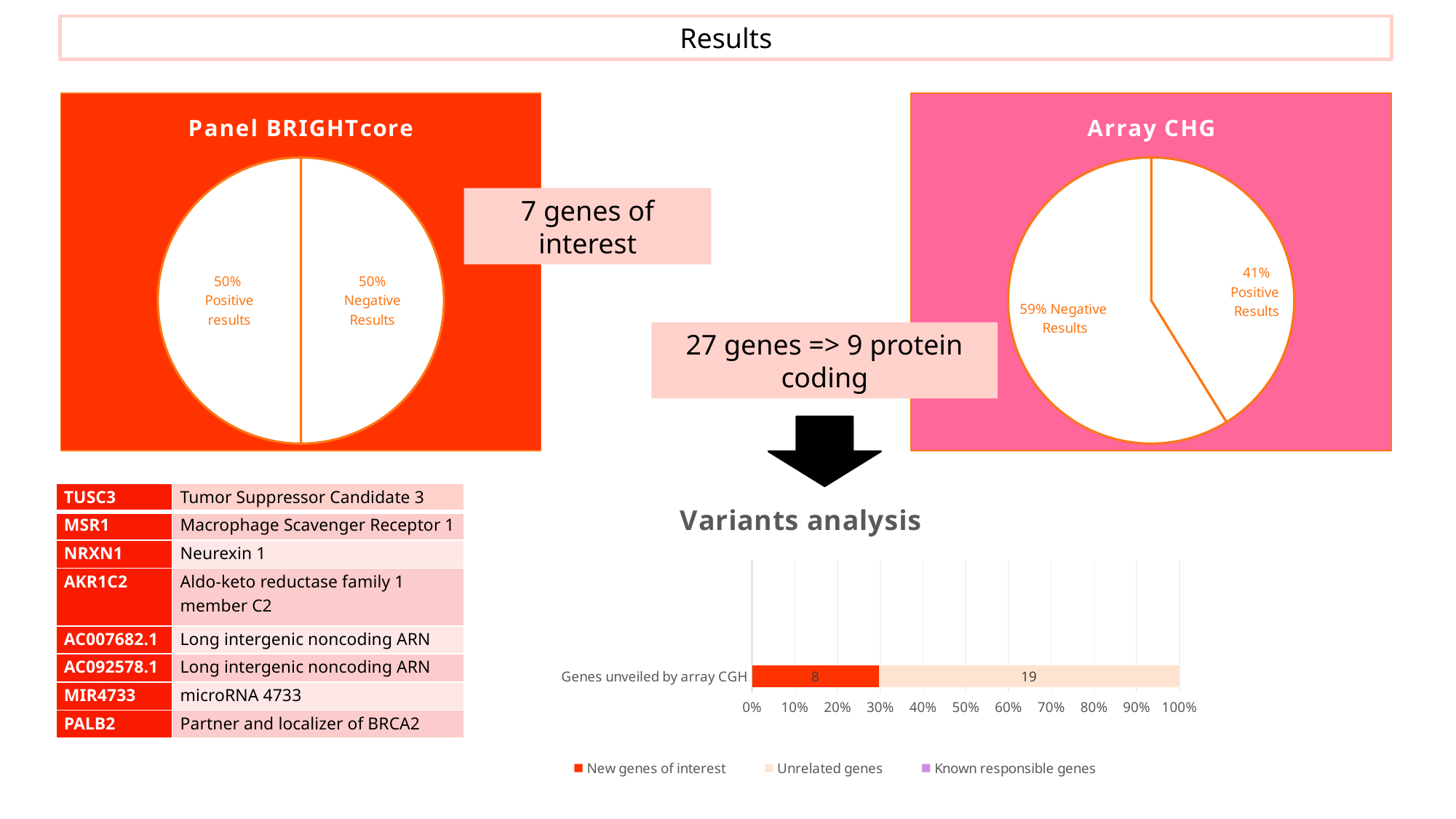
What kind of chart is the Array CHG chart? Pie chart In the Array CHG chart, which slice is larger, Negative Results or Positive Results? Negative Results How many series does the legend of the Variants analysis chart list? 3 In the Variants analysis chart, what is the value for Unrelated genes? 19 In the Panel BRIGHTcore chart, what share of the pie is Positive results? 50% In the Variants analysis chart, what is the value for New genes of interest? 8 In the Array CHG chart, what share of the pie is Negative Results? 59% In the Variants analysis chart, what is the sum of the New genes of interest and Unrelated genes segments? 27 In the Array CHG chart, what is the difference between the Negative Results share and the Positive Results share? 18% In the Panel BRIGHTcore chart, what share of the pie is Negative Results? 50% What kind of chart is the Variants analysis chart? Stacked bar chart